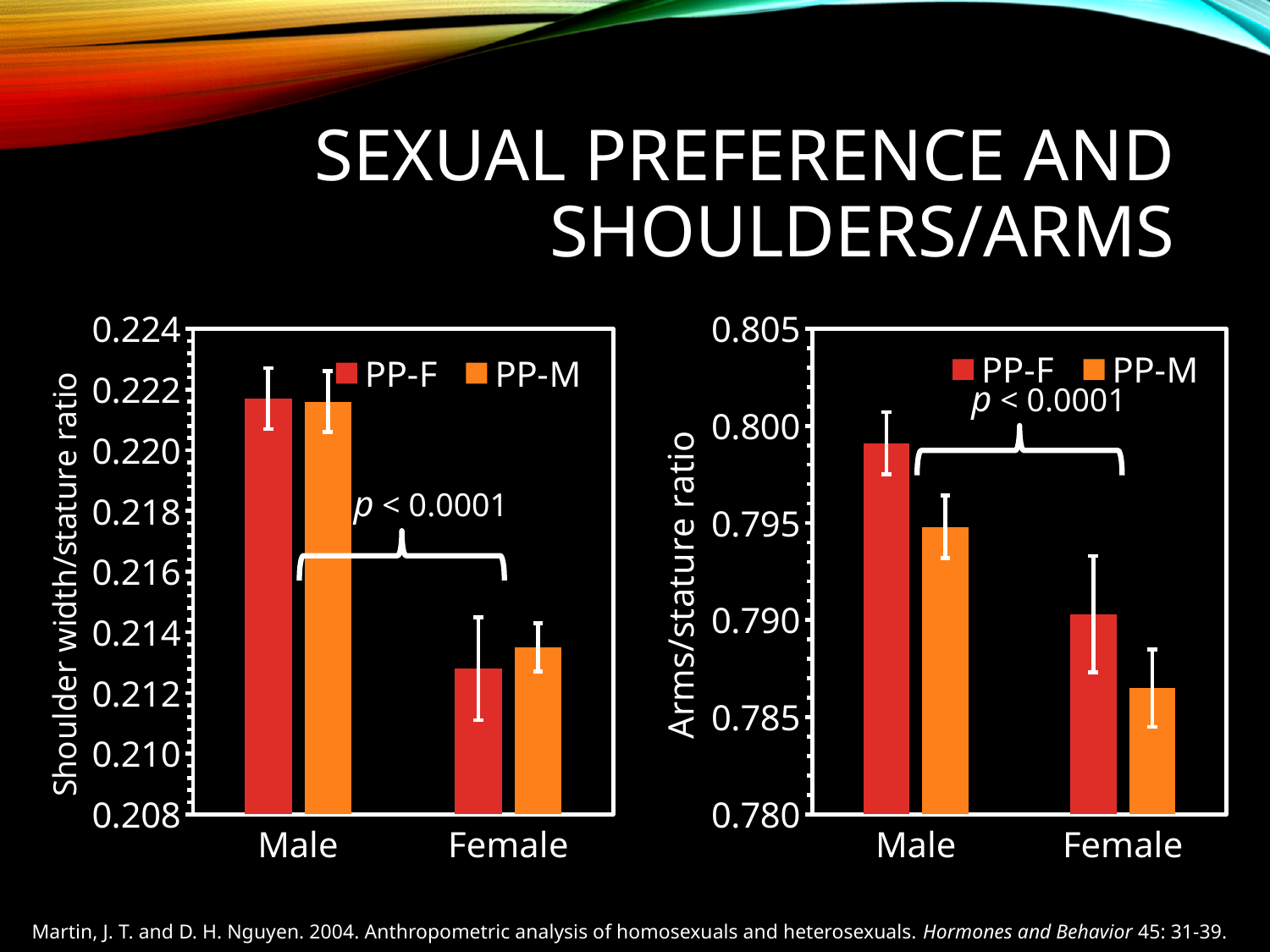
How many series does the legend of the right chart (Arms/stature ratio) list? 2 In the left chart (Shoulder width/stature ratio), is the PP-F value for Male greater or less than 0.220? greater In the right chart (Arms/stature ratio), is the PP-F value for Male greater or less than 0.795? greater How many categories are shown on the x axis of the left chart (Shoulder width/stature ratio)? 2 In the right chart (Arms/stature ratio), which is larger for Male: PP-F or PP-M? PP-F In the right chart (Arms/stature ratio), is the PP-M value for Female greater or less than 0.790? less What kind of chart is the left chart (Shoulder width/stature ratio)? bar chart In the right chart (Arms/stature ratio), which bar is the lowest? Female, PP-M In the right chart (Arms/stature ratio), which bar is the highest? Male, PP-F What is the y-axis title of the right chart? Arms/stature ratio In the left chart (Shoulder width/stature ratio), do the PP-M values rise or fall from Male to Female? fall